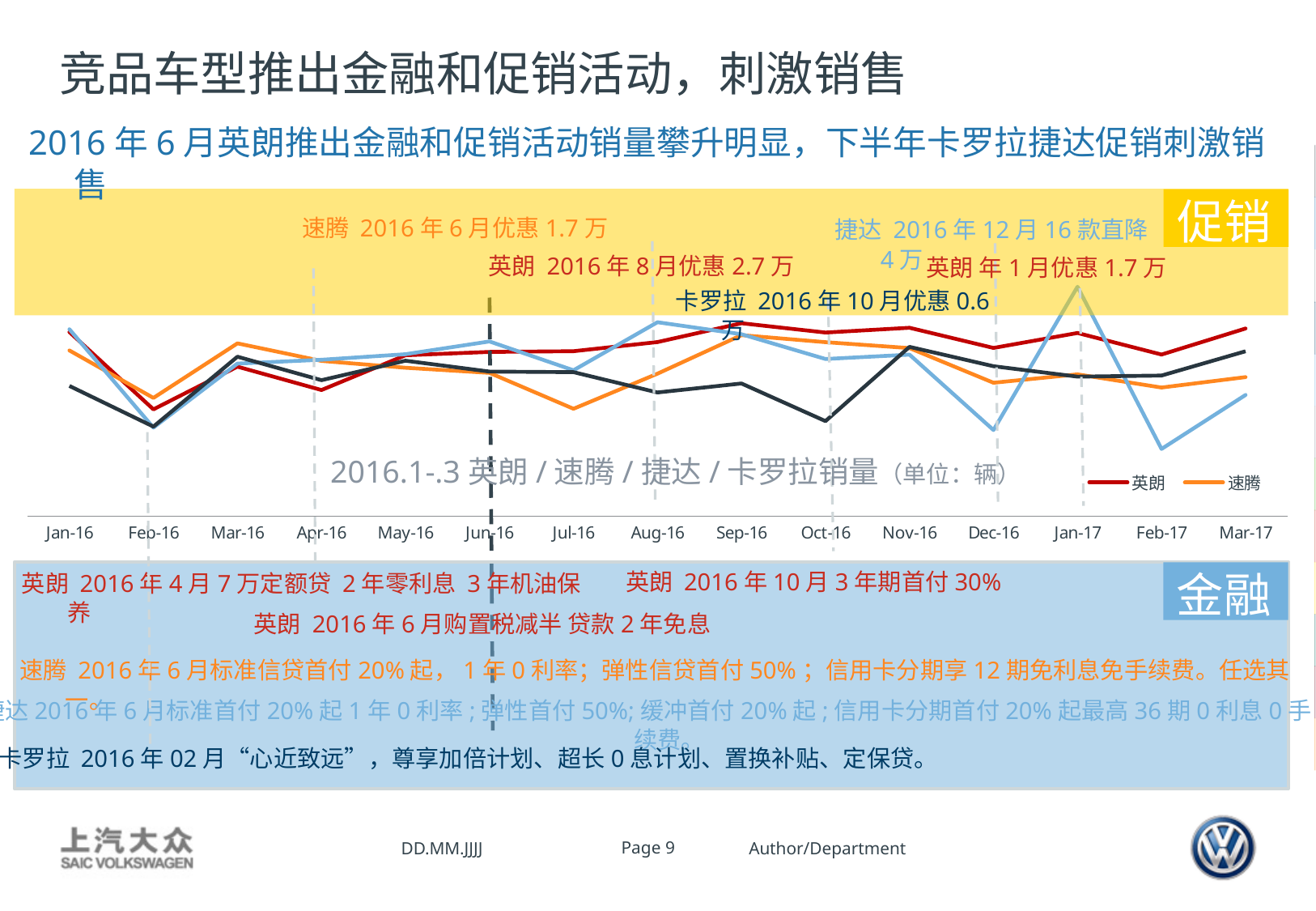
How many series does the chart's legend list? 2 What is the last month shown on the x axis of the chart? Mar-17 In Jul-16, which is higher, 英朗 or 速腾? 英朗 What kind of chart is shown on the slide? line chart Does the 速腾 line rise or fall from Jul-16 to Aug-16? rise In Dec-16, which is higher, 英朗 or 速腾? 英朗 Does the 英朗 line rise or fall from Feb-16 to Mar-16? rise Does the 速腾 line rise or fall from Jun-16 to Jul-16? fall How many months are shown along the x axis of the chart? 15 In which month is the 英朗 line at its lowest point? Feb-16 What is the first month shown on the x axis of the chart? Jan-16